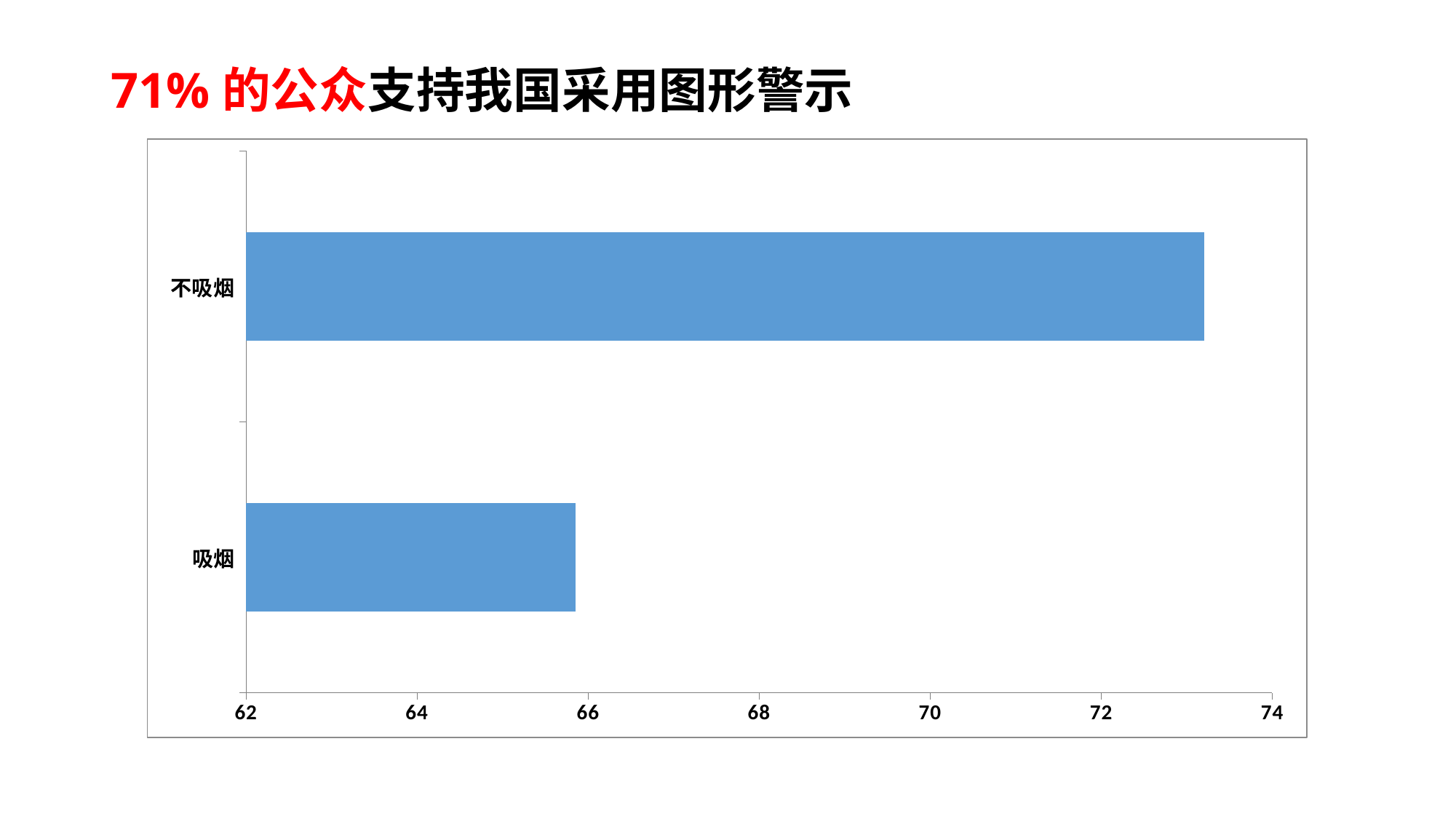
Which is larger, the value for 不吸烟 or the value for 吸烟? 不吸烟 Which category has the lowest value in the chart? 吸烟 How many categories are plotted in the chart? 2 Which category has the highest value in the chart? 不吸烟 Is the value for 吸烟 greater or less than 68? less What is the lowest value shown on the horizontal axis of the chart? 62 Is the value for 不吸烟 greater or less than 72? greater Is the value for 吸烟 greater or less than 64? greater What is the title text shown above the chart? 71% 的公众支持我国采用图形警示 What kind of chart is shown on the slide? bar chart